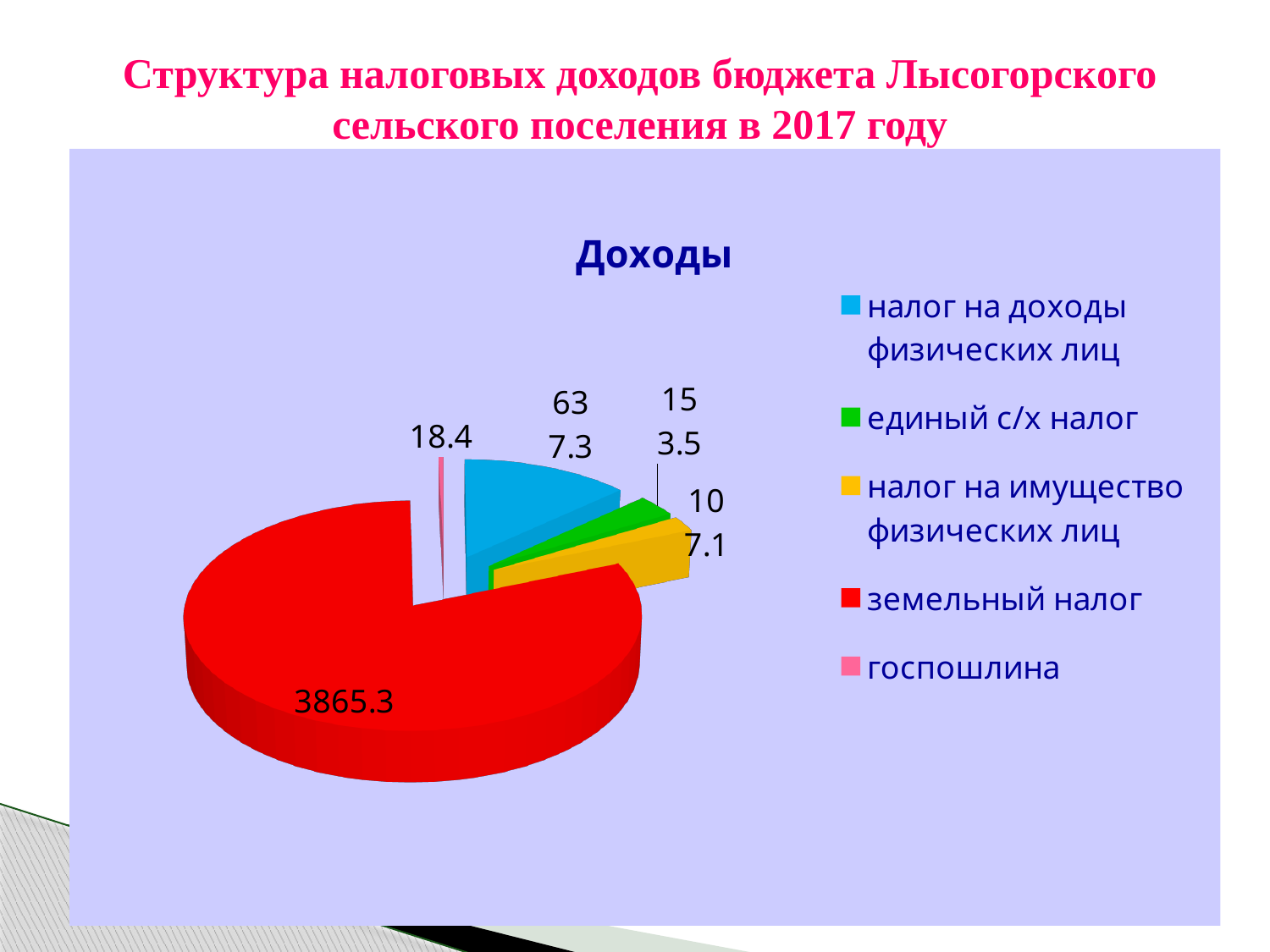
What is the value shown for госпошлина? 18.4 What is the value shown for земельный налог? 3865.3 What is the difference between the value for земельный налог and the value for госпошлина? 3846.9 What kind of chart is shown on the slide? pie chart How many entries does the chart legend list? 5 What is the value shown for налог на доходы физических лиц? 637.3 How many slices does the pie chart have? 5 What is the title of the chart? Доходы Which is larger, the value for земельный налог or the value for налог на доходы физических лиц? земельный налог Which category has the largest slice of the pie? земельный налог What colour is the slice for земельный налог? red Which category has the smallest slice of the pie? госпошлина